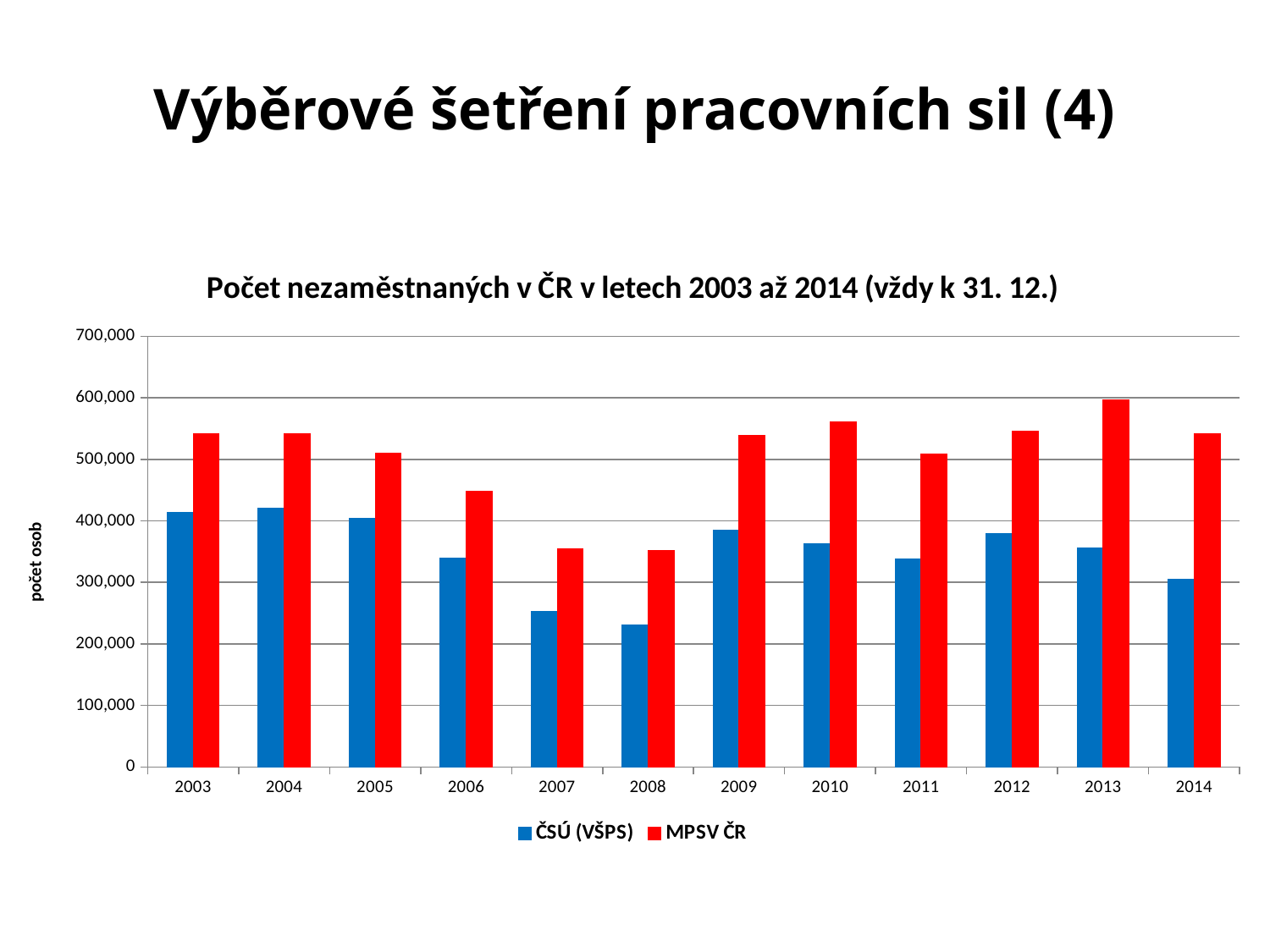
How many series does the legend list? 2 Is the MPSV ČR value for 2006 greater or less than 500,000? less What is the title of the chart? Počet nezaměstnaných v ČR v letech 2003 až 2014 (vždy k 31. 12.) What kind of chart is shown on the slide? bar chart Which is larger: the MPSV ČR value for 2013 or for 2014? 2013 Is the ČSÚ (VŠPS) value for 2007 greater or less than 300,000? less Is the MPSV ČR value for 2010 greater or less than 500,000? greater Do the ČSÚ (VŠPS) values rise or fall from 2004 to 2008? fall In which year is the ČSÚ (VŠPS) value lowest? 2008 How many years are shown on the x axis? 12 In which year is the MPSV ČR value highest? 2013